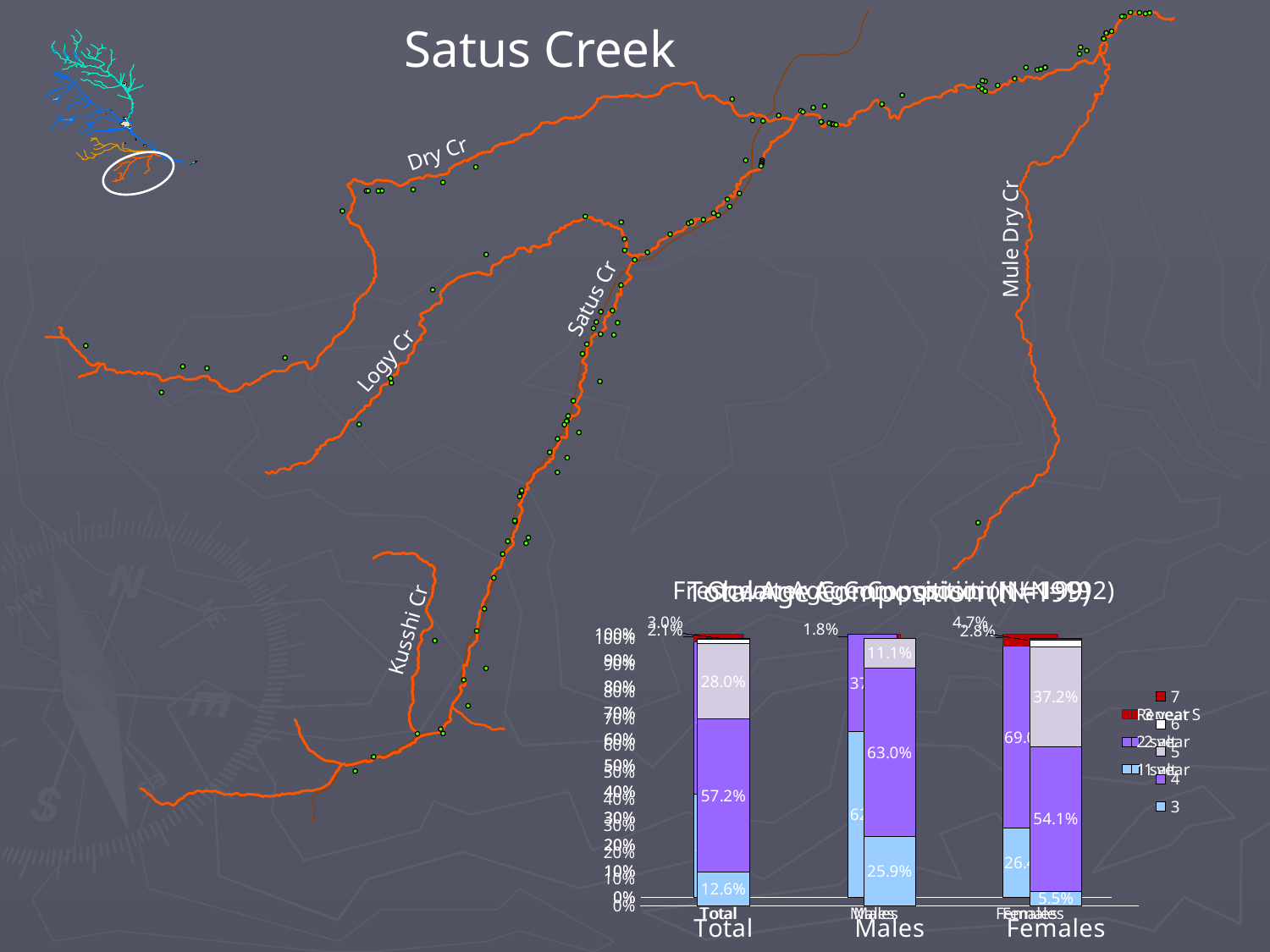
In the bottom-right bar chart, what is the value of the light grey segment of the Females bar? 37.2% How many categories are shown along the x axis of the bar chart in the bottom right? 3 In the bottom-right bar chart, what is the value of the light grey segment of the Total bar? 28.0% In the bottom-right bar chart, what is the value of the bottom (light blue) segment of the Total bar? 12.6% In the bottom-right bar chart, what are the three categories on the x axis? Total, Males, Females In the bottom-right bar chart, which is larger in the Total bar: the purple segment or the light grey segment? The purple segment (57.2%) In the bottom-right bar chart, what is the value of the purple segment of the Total bar? 57.2% In the bottom-right bar chart, what is the value of the bottom (light blue) segment of the Males bar? 25.9% In the bottom-right bar chart, what is the value of the purple segment of the Males bar? 63.0% In the bottom-right bar chart, what is the value of the bottom (light blue) segment of the Females bar? 5.5% In the bottom-right bar chart, what is the difference between the purple segment (57.2%) and the light blue segment (12.6%) of the Total bar? 44.6 percentage points What kind of chart is shown in the bottom right of the slide? Stacked bar chart